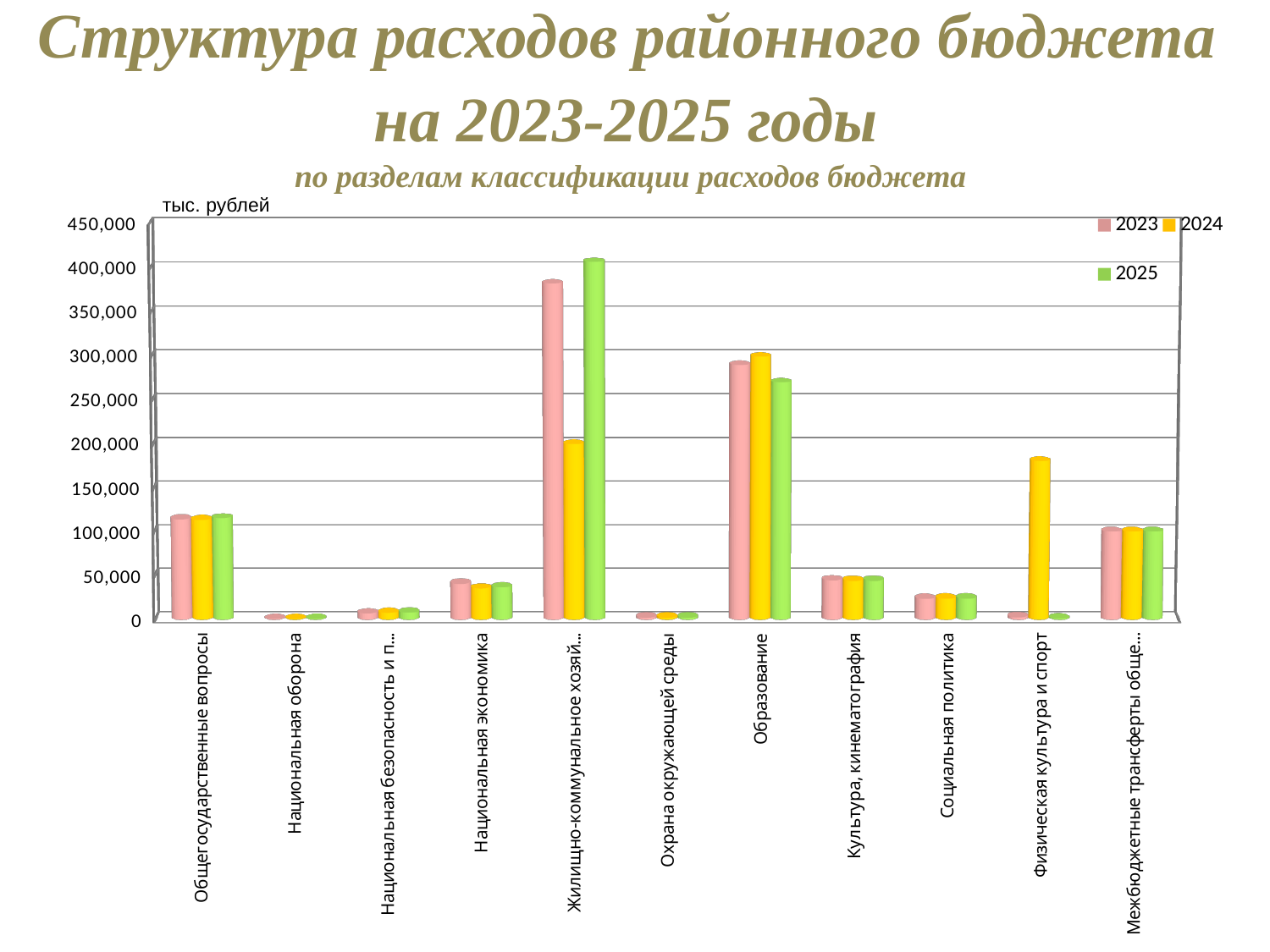
Which category has the highest value for the 2023 series? Жилищно-коммунальное хозяйство Which category has the highest value for the 2025 series? Жилищно-коммунальное хозяйство How many series does the legend list? 3 Which category has the highest value for the 2024 series? Образование What kind of chart is shown on the slide? bar chart What unit is indicated above the vertical axis of the chart? тыс. рублей For 2025, which is larger: the value for Жилищно-коммунальное хозяйство or the value for Образование? Жилищно-коммунальное хозяйство For Физическая культура и спорт, which is larger: the 2023 value or the 2024 value? 2024 Is the 2024 value for Физическая культура и спорт greater or less than 150,000? greater How many categories are shown along the x axis? 11 Is the 2024 value for Жилищно-коммунальное хозяйство greater or less than 250,000? less Is the 2024 value for Образование greater or less than 250,000? greater